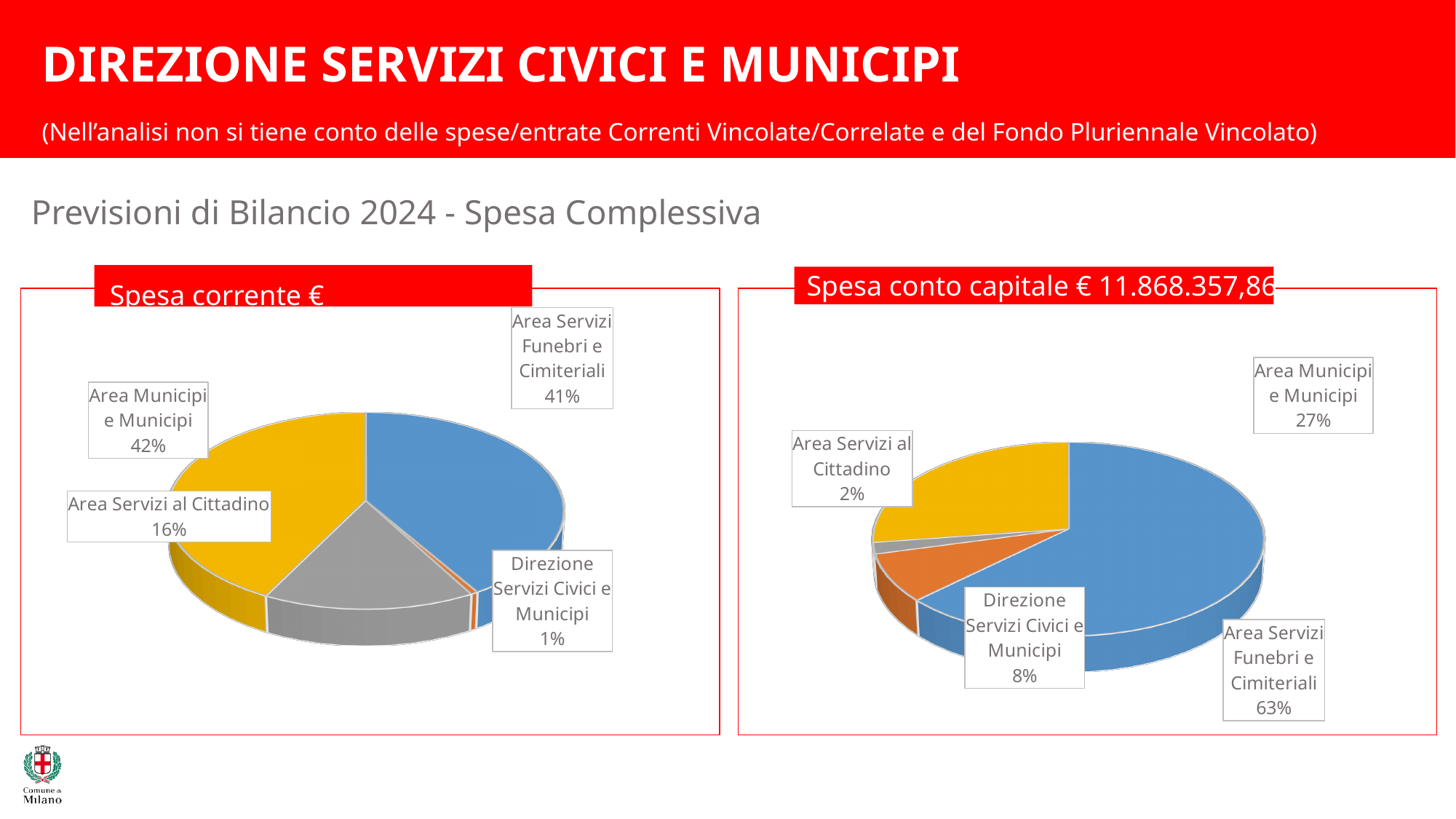
In the Spesa conto capitale chart, which is larger: Area Municipi e Municipi or Direzione Servizi Civici e Municipi? Area Municipi e Municipi What total amount is shown in the title of the Spesa conto capitale chart? € 11.868.357,86 In the Spesa corrente chart, how many slices does the pie have? 4 In the Spesa corrente chart, what share does Area Servizi Funebri e Cimiteriali have? 41% In the Spesa corrente chart, which category has the smallest share? Direzione Servizi Civici e Municipi In the Spesa conto capitale chart, what share does Direzione Servizi Civici e Municipi have? 8% In the Spesa corrente chart, which category has the largest share? Area Municipi e Municipi What kind of chart is the Spesa conto capitale chart? Pie chart In the Spesa conto capitale chart, what is the difference in percentage points between Area Servizi Funebri e Cimiteriali and Area Municipi e Municipi? 36 In the Spesa conto capitale chart, which category has the smallest share? Area Servizi al Cittadino In the Spesa corrente chart, what share does Area Servizi al Cittadino have? 16%